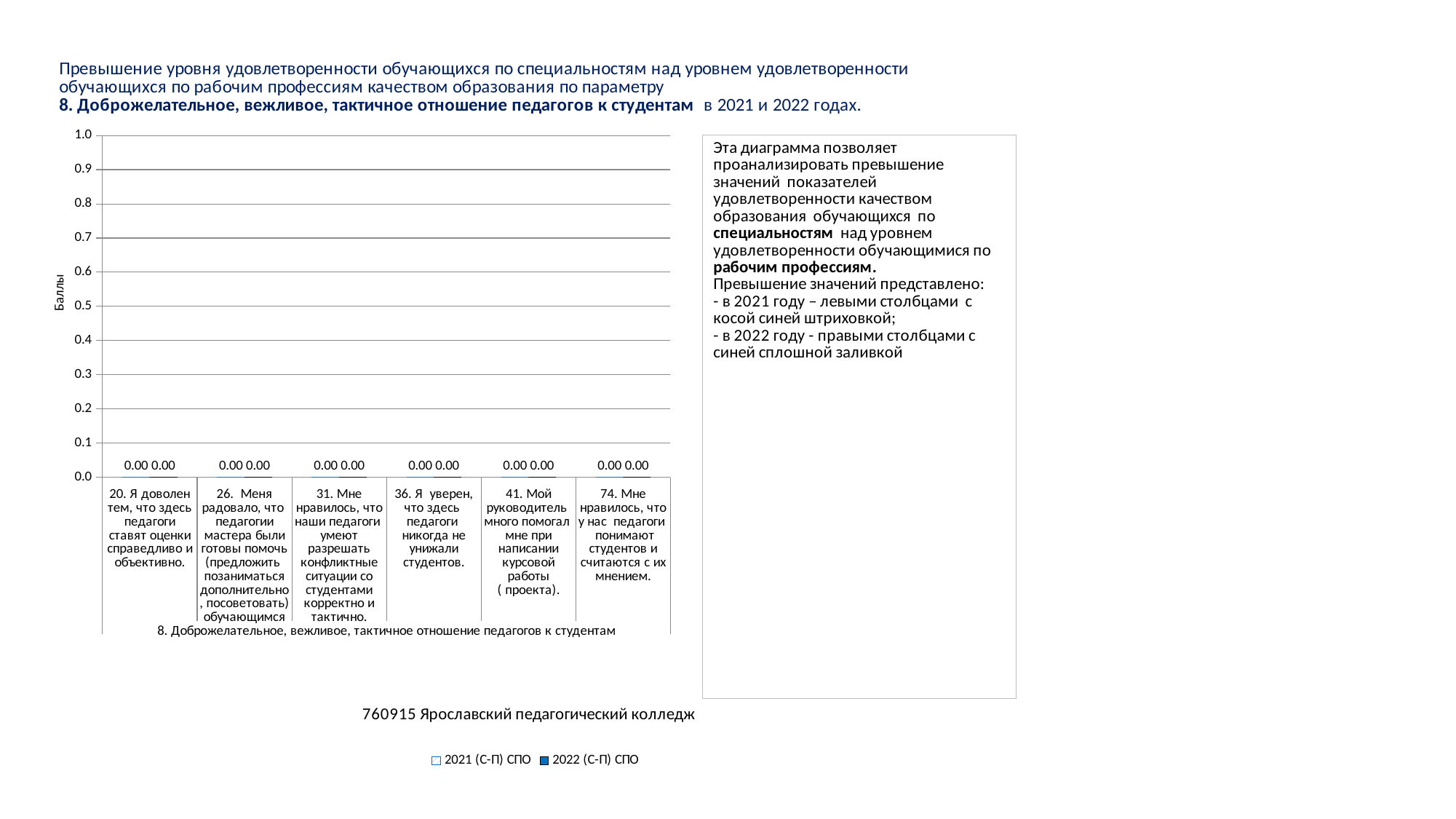
What are the two series names listed in the chart legend? 2021 (С-П) СПО and 2022 (С-П) СПО What is the value for the 2021 (С-П) СПО series for category 20 (Я доволен тем, что здесь педагоги ставят оценки справедливо и объективно)? 0.00 How many categories are shown on the x axis of the chart? 6 What is the value for the 2021 (С-П) СПО series for category 74 (Мне нравилось, что у нас педагоги понимают студентов и считаются с их мнением)? 0.00 How many series does the chart legend list? 2 What is the difference between the 2021 (С-П) СПО and 2022 (С-П) СПО values for category 31 (Мне нравилось, что наши педагоги умеют разрешать конфликтные ситуации со студентами корректно и тактично)? 0.00 What is the label of the vertical axis of the chart? Баллы What is the value for the 2022 (С-П) СПО series for category 36 (Я уверен, что здесь педагоги никогда не унижали студентов)? 0.00 What kind of chart is shown on the slide? bar chart What is the value for the 2022 (С-П) СПО series for category 41 (Мой руководитель много помогал мне при написании курсовой работы)? 0.00 Is the value for the 2022 (С-П) СПО series for category 26 (Меня радовало, что педагогии мастера были готовы помочь) greater or less than 0.1? less